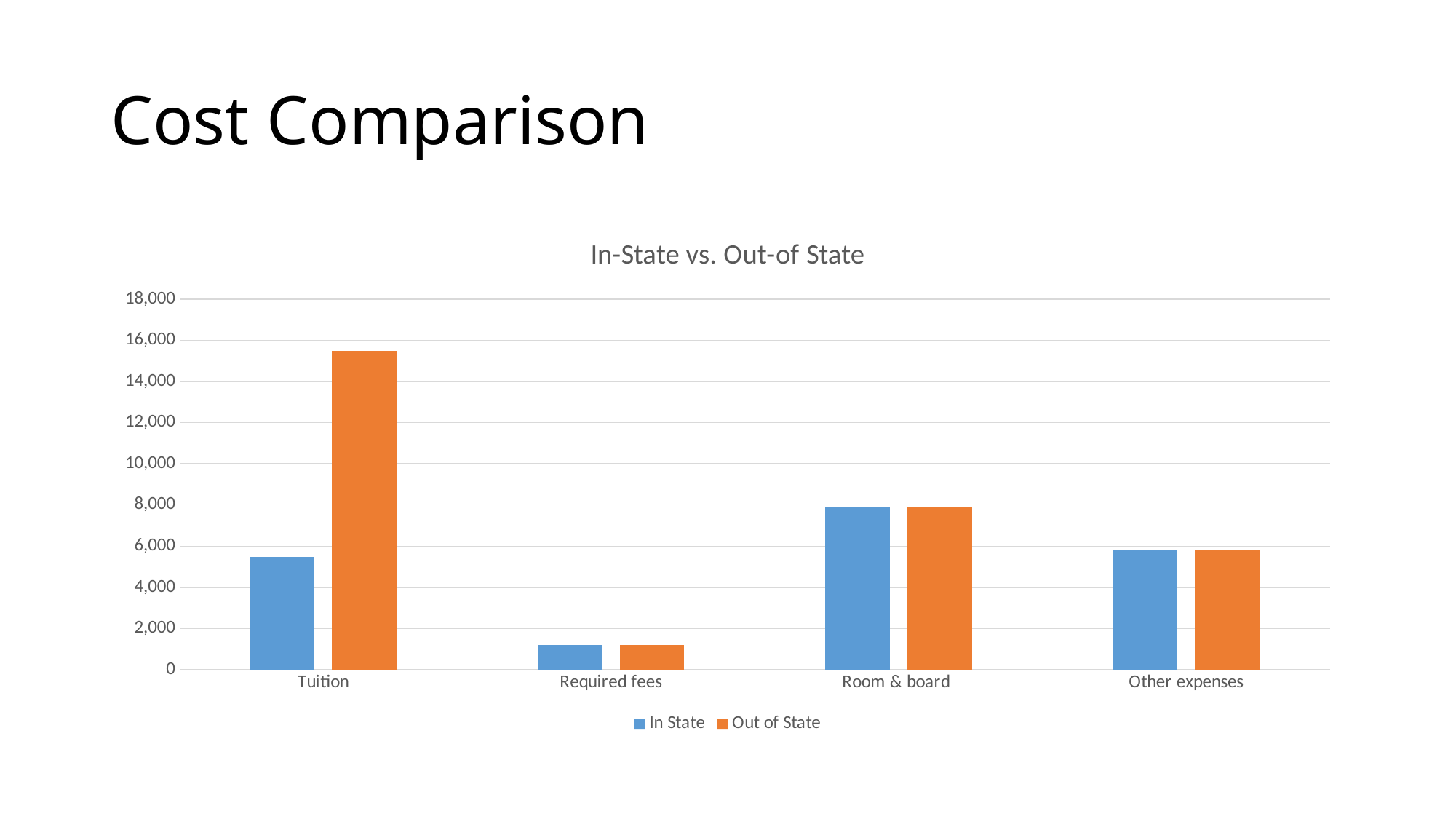
Is the In State value for Tuition greater or less than 4,000? greater Which category has the highest In State value? Room & board Which category has the highest Out of State value? Tuition How many series does the legend list? 2 Is the Out of State value for Tuition greater or less than 14,000? greater Which category has the lowest In State value? Required fees Is the In State value for Required fees greater or less than 2,000? less For Tuition, which is larger: the In State value or the Out of State value? Out of State For the In State series, which is larger: Room & board or Other expenses? Room & board What kind of chart is shown on the slide? bar chart How many categories are shown on the x axis? 4 What is the title of the chart? In-State vs. Out-of State